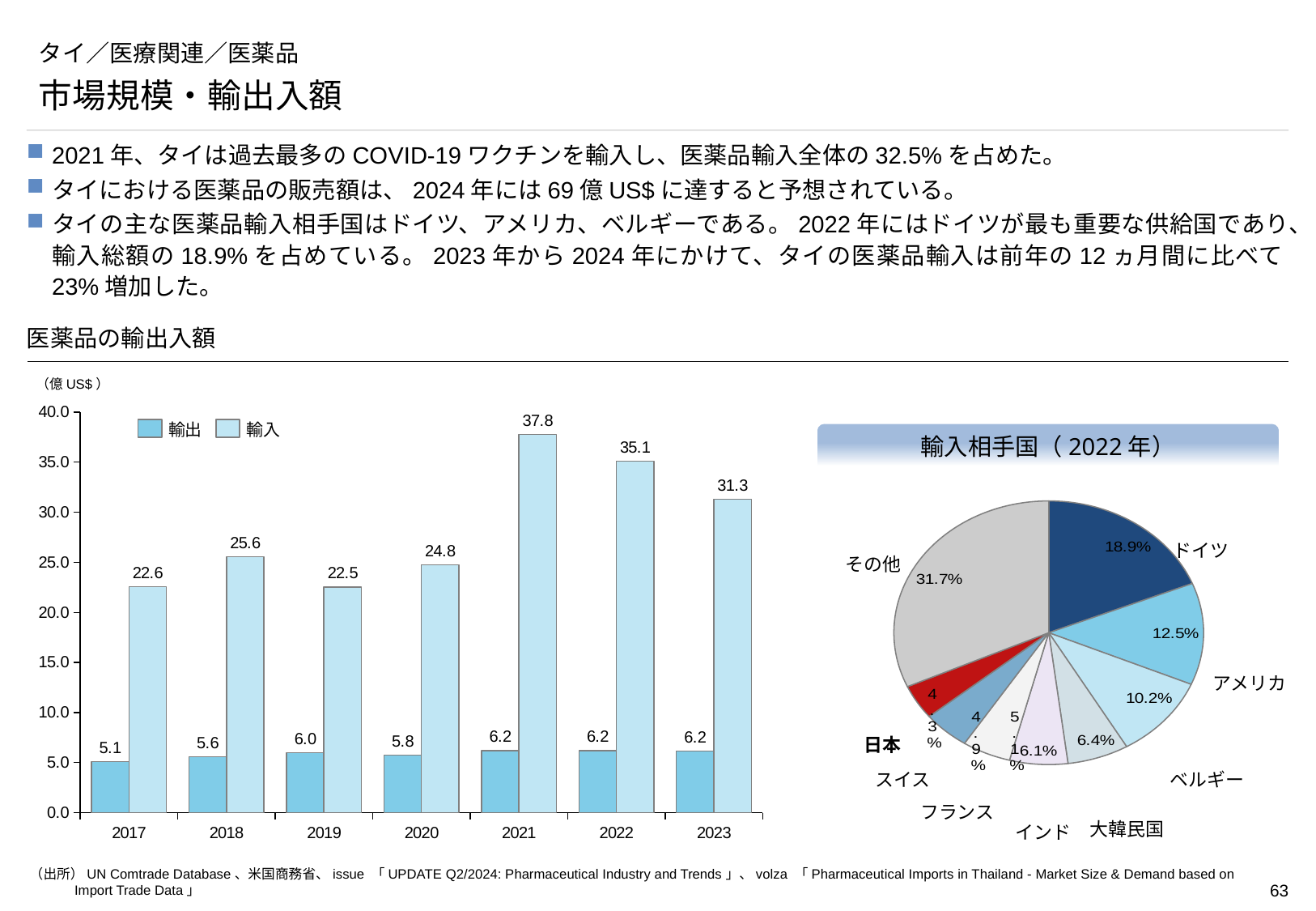
What kind of chart is the chart on the left (医薬品の輸出入額)? bar chart In the bar chart on the left, which year has the highest 輸入 value? 2021 In the pie chart 輸入相手国（2022年）, which slice is the largest? その他 In the pie chart 輸入相手国（2022年）, what share does ドイツ have? 18.9% In the bar chart on the left, which year has the lowest 輸出 value? 2017 In the bar chart on the left, what is the difference between 輸入 and 輸出 in 2021? 31.6 In the bar chart on the left, how many series does the legend list? 2 In the bar chart on the left, which year has the larger 輸入 value, 2018 or 2020? 2018 In the bar chart on the left, do the 輸入 values rise or fall from 2021 to 2023? fall In the bar chart on the left, what is the 輸入 value for 2021? 37.8 In the bar chart on the left, how many years are shown on the x axis? 7 In the bar chart on the left, what is the 輸出 value for 2017? 5.1